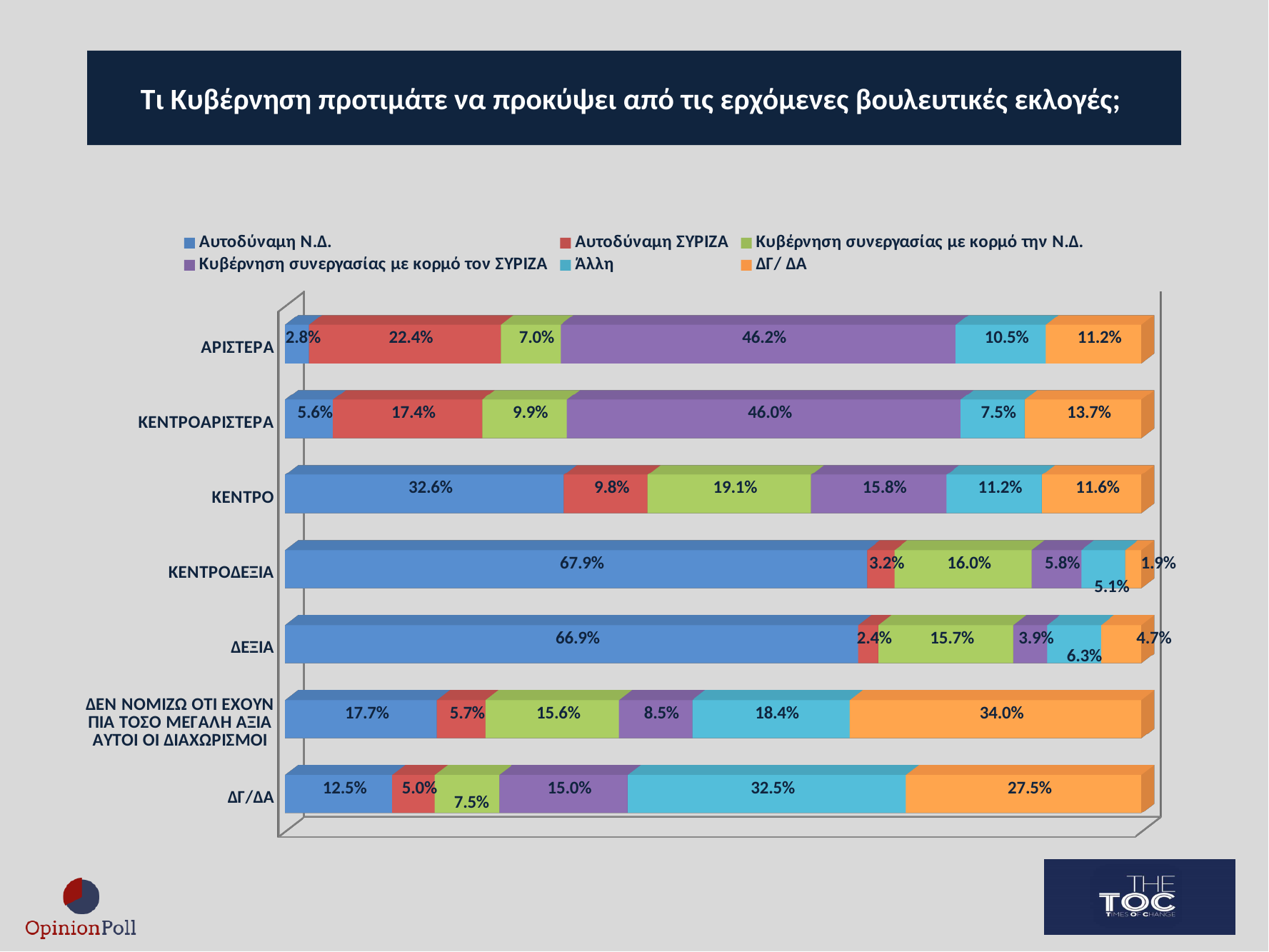
Which category has the highest value for Αυτοδύναμη Ν.Δ.? ΚΕΝΤΡΟΔΕΞΙΑ How many series does the legend list? 6 What kind of chart is shown on the slide? Stacked bar chart How many categories are shown on the chart? 7 Which category has the lowest value for Αυτοδύναμη Ν.Δ.? ΑΡΙΣΤΕΡΑ What percentage of ΑΡΙΣΤΕΡΑ respondents prefer Κυβέρνηση συνεργασίας με κορμό τον ΣΥΡΙΖΑ? 46.2% Which is larger: the Κυβέρνηση συνεργασίας με κορμό την Ν.Δ. value for ΚΕΝΤΡΟ or for ΚΕΝΤΡΟΔΕΞΙΑ? ΚΕΝΤΡΟ Which colour represents Άλλη in the legend? Light blue What is the ΔΓ/ ΔΑ value for the category ΔΕΝ ΝΟΜΙΖΩ ΟΤΙ ΕΧΟΥΝ ΠΙΑ ΤΟΣΟ ΜΕΓΑΛΗ ΑΞΙΑ ΑΥΤΟΙ ΟΙ ΔΙΑΧΩΡΙΣΜΟΙ? 34.0% What is the value for Άλλη in the ΔΓ/ΔΑ category? 32.5% What is the difference between the Αυτοδύναμη ΣΥΡΙΖΑ values for ΑΡΙΣΤΕΡΑ and ΚΕΝΤΡΟΑΡΙΣΤΕΡΑ? 5.0 percentage points What is the value for Αυτοδύναμη Ν.Δ. in the ΚΕΝΤΡΟ category? 32.6%